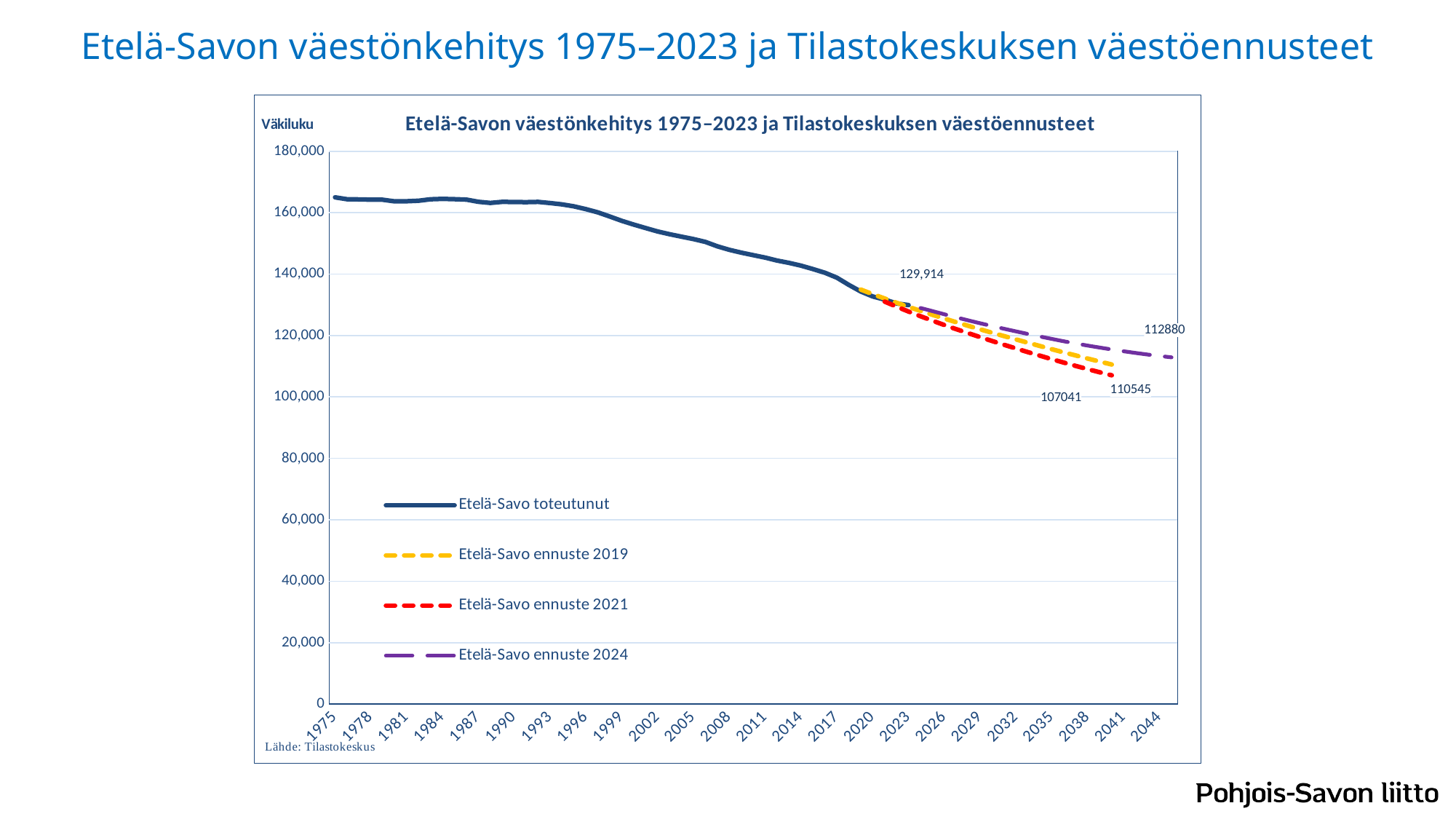
What is the labelled end value of the Etelä-Savo ennuste 2024 line? 112880 Which ends at a higher labelled value, Etelä-Savo ennuste 2019 or Etelä-Savo ennuste 2021? Etelä-Savo ennuste 2019 What is the label on the vertical axis of the chart? Väkiluku What is the labelled end value of the Etelä-Savo ennuste 2021 line? 107041 Does the Etelä-Savo toteutunut line rise or fall from 1975 to 2023? fall What is the difference between the labelled end values of Etelä-Savo ennuste 2024 and Etelä-Savo ennuste 2021? 5839 How many series does the legend list? 4 What is the labelled value at the end of the Etelä-Savo toteutunut line? 129,914 Which forecast series ends at the lowest labelled value? Etelä-Savo ennuste 2021 Is the value of the Etelä-Savo toteutunut line in 1975 greater or less than 160,000? greater What kind of chart is shown on the slide? line chart What is the labelled end value of the Etelä-Savo ennuste 2019 line? 110545